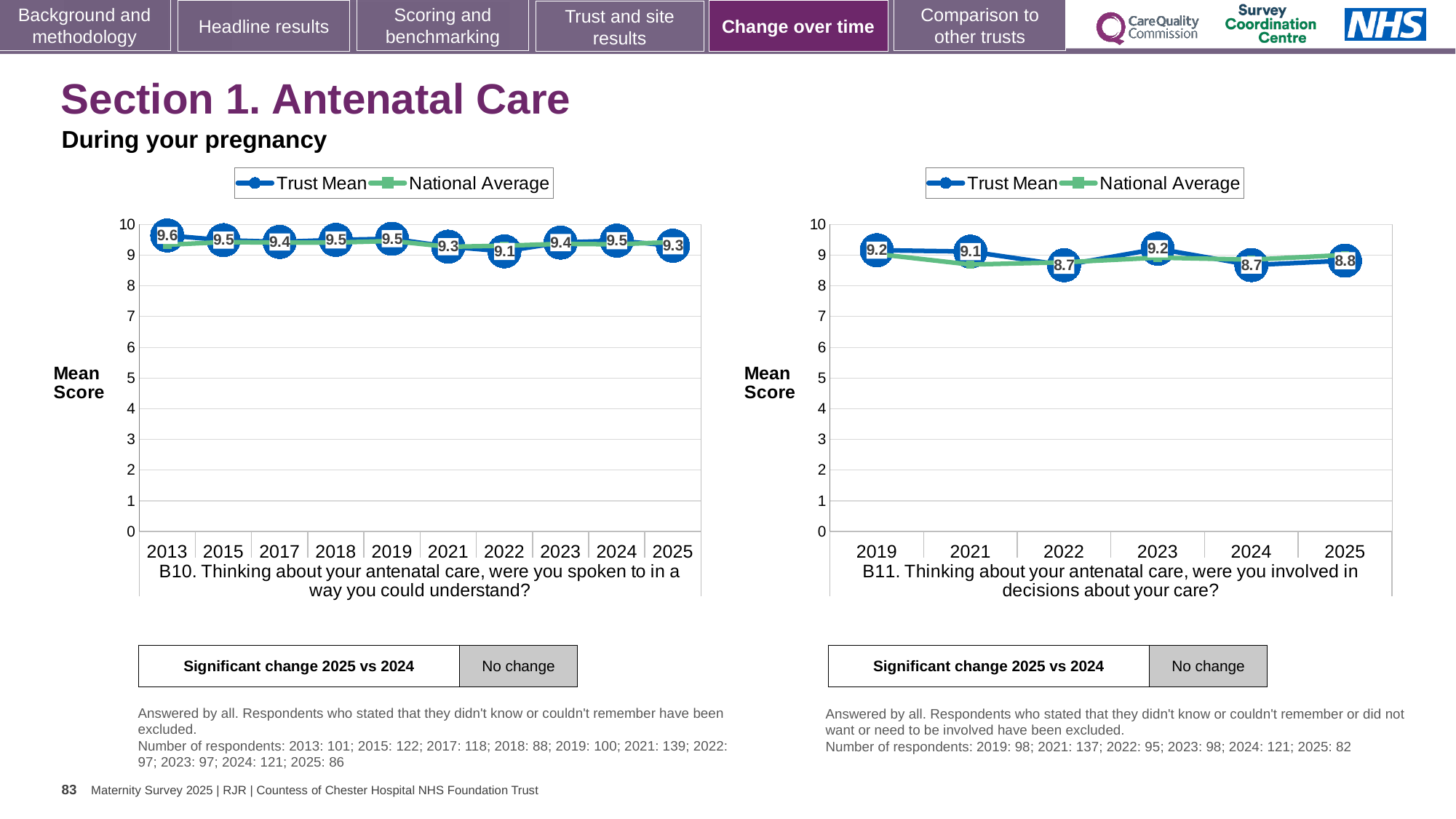
In the B11 chart, what is the Trust Mean for 2023? 9.2 In the B11 chart, is the Trust Mean for 2021 larger or smaller than the Trust Mean for 2022? larger In the B10 chart, what is the difference between the Trust Mean in 2013 and in 2022? 0.5 In the B11 chart, how many series does the legend list? 2 In the B10 chart, which year has the highest Trust Mean? 2013 In the B10 chart, what is the Trust Mean for 2022? 9.1 In the B11 chart, what is the difference between the Trust Mean in 2023 and in 2024? 0.5 What type of chart is the B11 chart? Line chart In the B10 chart, how many years are shown on the x axis? 10 In the B10 chart, what is the Trust Mean for 2013? 9.6 In the B11 chart, what is the Trust Mean for 2025? 8.8 In the B10 chart, which year has the lowest Trust Mean? 2022